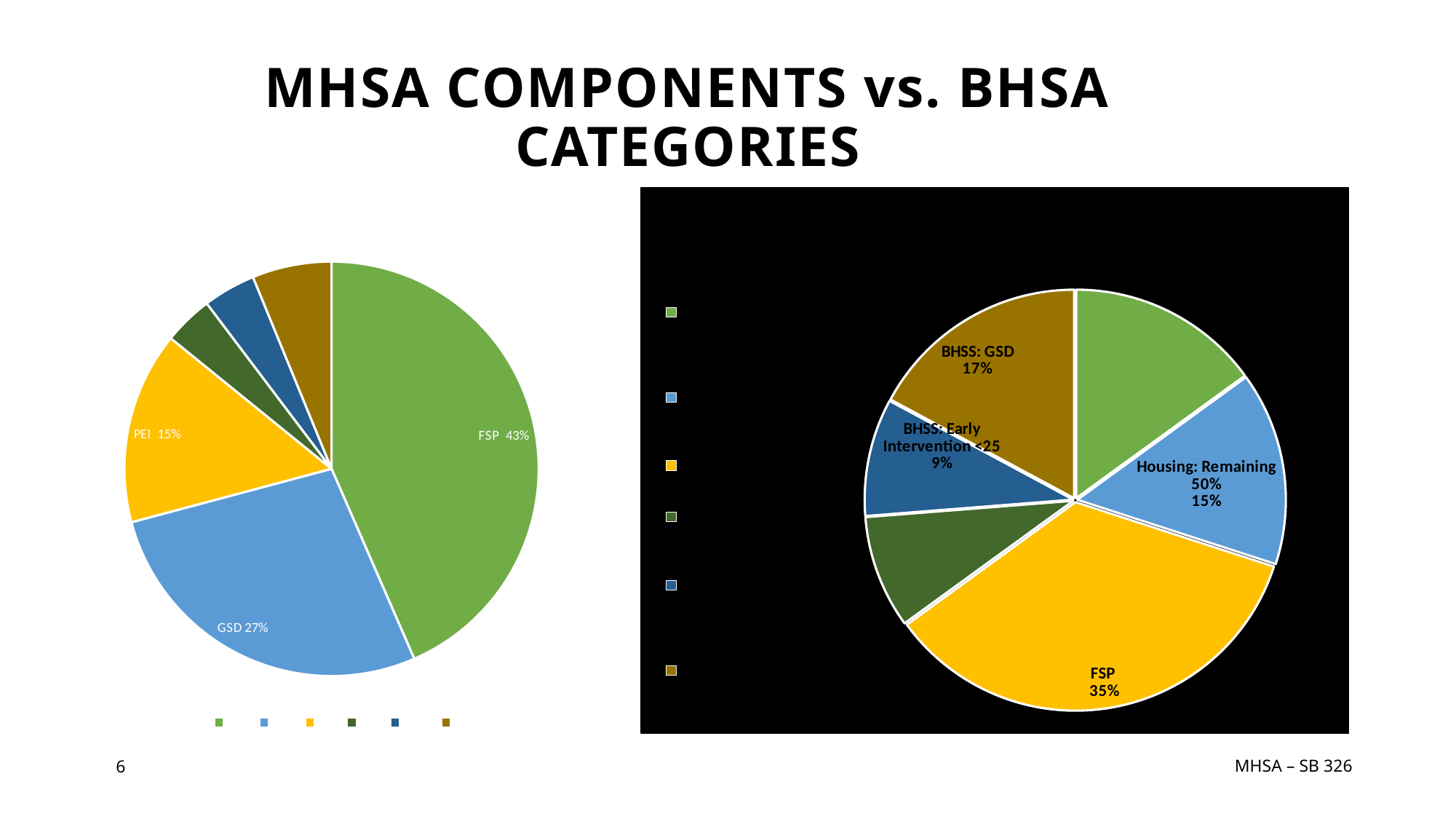
On the left pie chart, what percentage is shown for PEI? 15% On the right pie chart (black background), what percentage is shown for Housing: Remaining 50%? 15% On the left pie chart, which labelled slice is the largest? FSP On the left pie chart, how many percentage points larger is FSP than GSD? 16 percentage points What type of chart is shown on the left side of the slide? Pie chart On the right pie chart (black background), which labelled slice is the largest? FSP On the right pie chart (black background), what percentage is shown for BHSS: Early Intervention <25? 9% On the left pie chart, what percentage is shown for GSD? 27% On the left pie chart, what percentage is shown for FSP? 43% On the right pie chart (black background), what percentage is shown for BHSS: GSD? 17% On the right pie chart (black background), what percentage is shown for FSP? 35% On the right pie chart (black background), which is larger, BHSS: GSD or BHSS: Early Intervention <25? BHSS: GSD